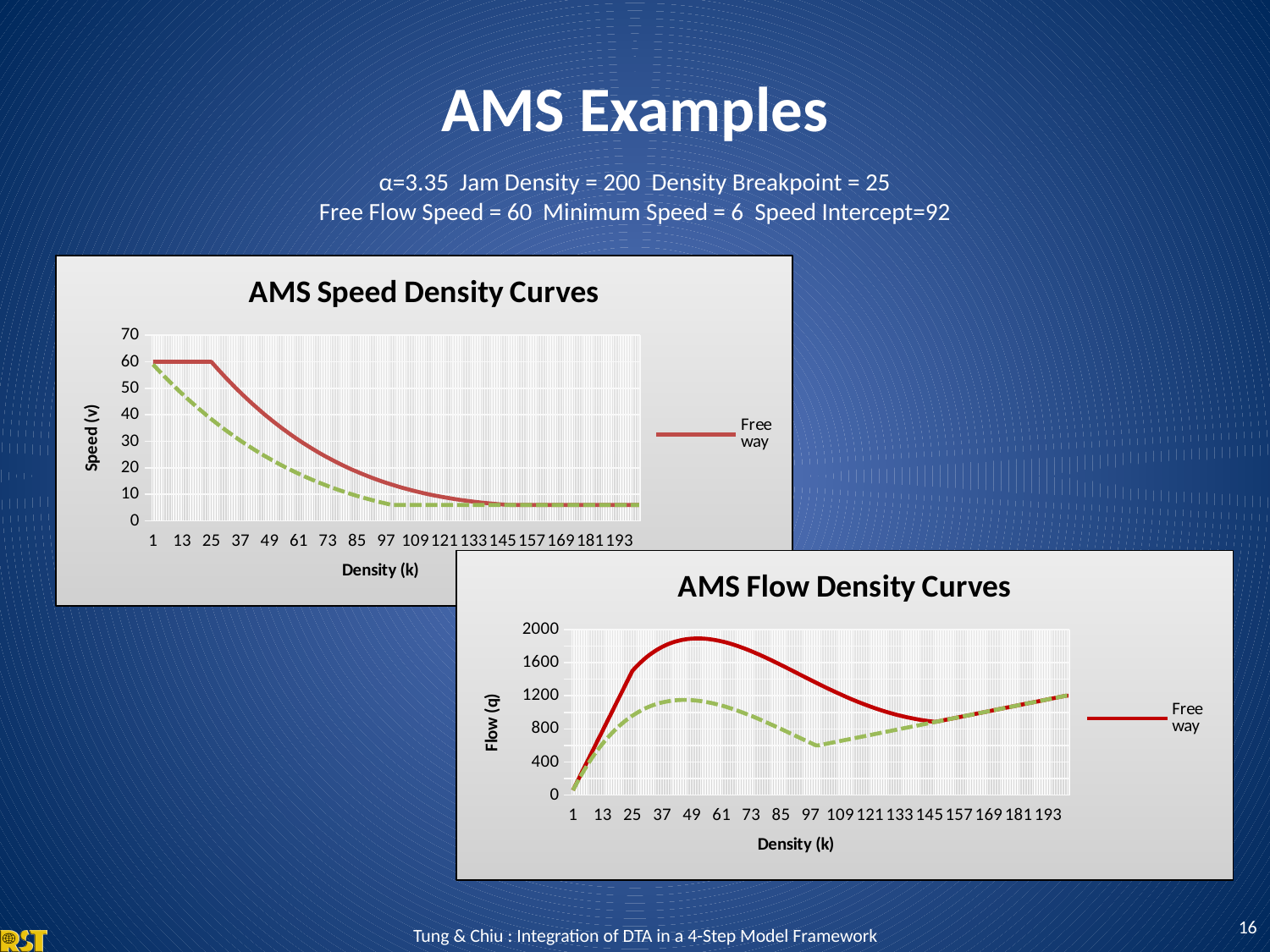
What kind of chart is the 'AMS Speed Density Curves' chart? line chart In the 'AMS Flow Density Curves' chart, what is the label of the vertical axis? Flow (q) How many density tick labels are shown on the horizontal axis of the 'AMS Flow Density Curves' chart? 17 In the 'AMS Speed Density Curves' chart, does the solid line rise or fall as density increases beyond 25? fall In the 'AMS Flow Density Curves' chart, is the dashed line's value at density 49 greater or less than 800? greater What is the title of the lower chart on the slide? AMS Flow Density Curves In the 'AMS Speed Density Curves' chart, what is the largest density value labelled on the horizontal axis? 193 In the 'AMS Speed Density Curves' chart, what speed value does the solid line show at density 13? 60 In the 'AMS Speed Density Curves' chart, is the solid line's value at density 145 greater or less than 10? less In the 'AMS Flow Density Curves' chart, is the solid line's value at density 49 greater or less than 1600? greater In the 'AMS Flow Density Curves' chart, at density 49, which line has the larger flow value, the solid line or the dashed line? the solid line